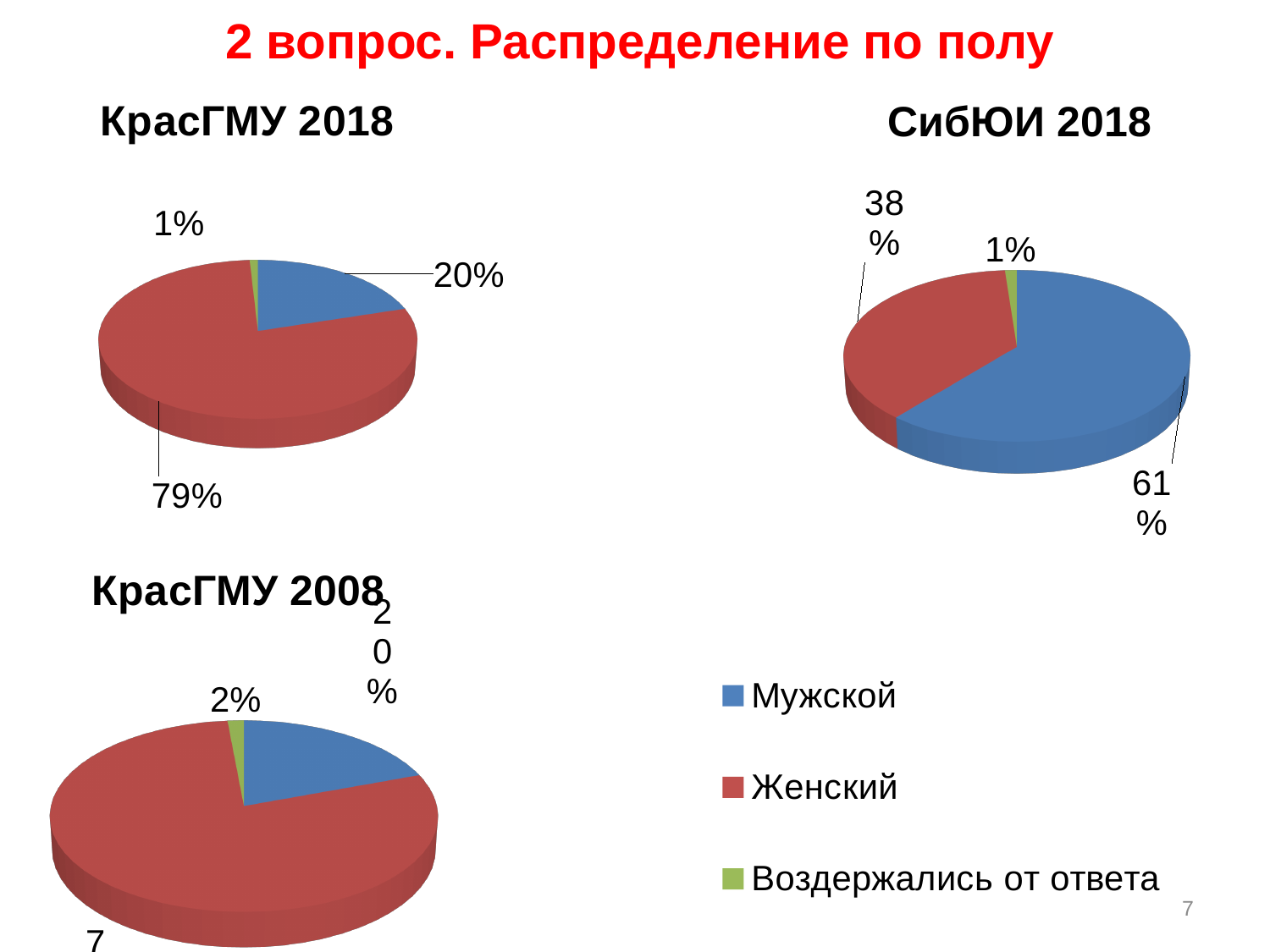
In the КрасГМУ 2018 chart, which is larger, Мужской or Женский? Женский In the СибЮИ 2018 chart, what share is Женский? 38% What type of chart is used on this slide? Pie chart In the КрасГМУ 2018 chart, which category has the smallest slice? Воздержались от ответа In the КрасГМУ 2008 chart, which category has the largest slice? Женский In the СибЮИ 2018 chart, what is the difference between the Мужской and Женский shares? 23% In the КрасГМУ 2008 chart, what share is Воздержались от ответа? 2% In the СибЮИ 2018 chart, which category has the largest slice? Мужской How many categories does the legend list? 3 In the КрасГМУ 2018 chart, what share is Мужской? 20% In the СибЮИ 2018 chart, what share is Мужской? 61% In the КрасГМУ 2018 chart, what share is Женский? 79%